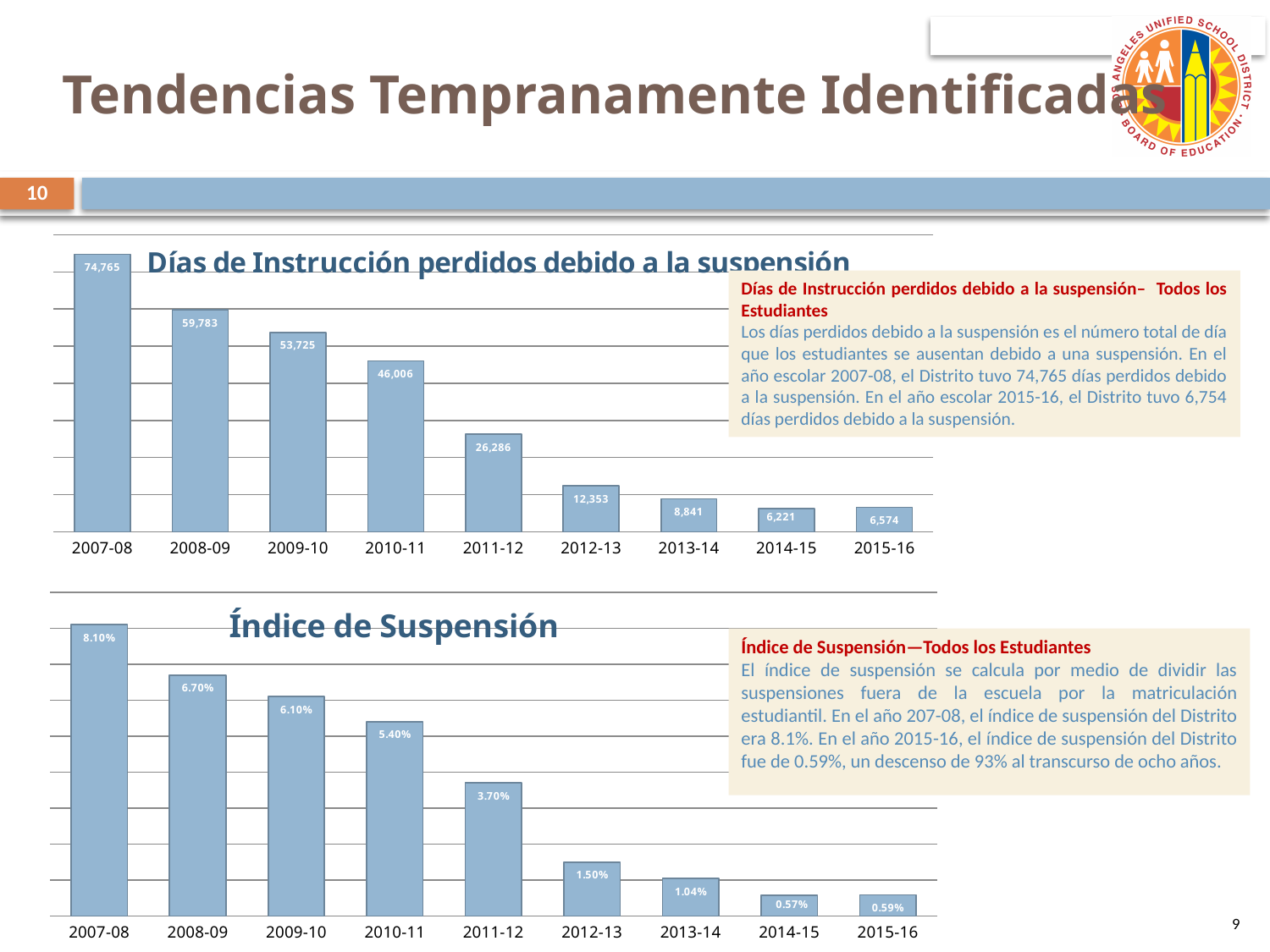
In the chart 'Índice de Suspensión', which year has the highest value? 2007-08 What kind of chart is 'Índice de Suspensión'? bar chart In the chart 'Días de Instrucción perdidos debido a la suspensión', what is the value for 2011-12? 26,286 In the chart 'Días de Instrucción perdidos debido a la suspensión', what is the value for 2007-08? 74,765 In the chart 'Índice de Suspensión', which is larger, the value for 2014-15 or 2015-16? 2015-16 In the chart 'Índice de Suspensión', what is the difference between the values for 2007-08 and 2015-16? 7.51% In the chart 'Días de Instrucción perdidos debido a la suspensión', what is the difference between the values for 2007-08 and 2008-09? 14,982 In the chart 'Días de Instrucción perdidos debido a la suspensión', which year has the lowest value? 2014-15 In the chart 'Índice de Suspensión', what is the value for 2015-16? 0.59% In the chart 'Índice de Suspensión', what is the value for 2010-11? 5.40% In the chart 'Días de Instrucción perdidos debido a la suspensión', do the values generally rise or fall from 2007-08 to 2015-16? fall In the chart 'Días de Instrucción perdidos debido a la suspensión', how many years are shown on the x axis? 9